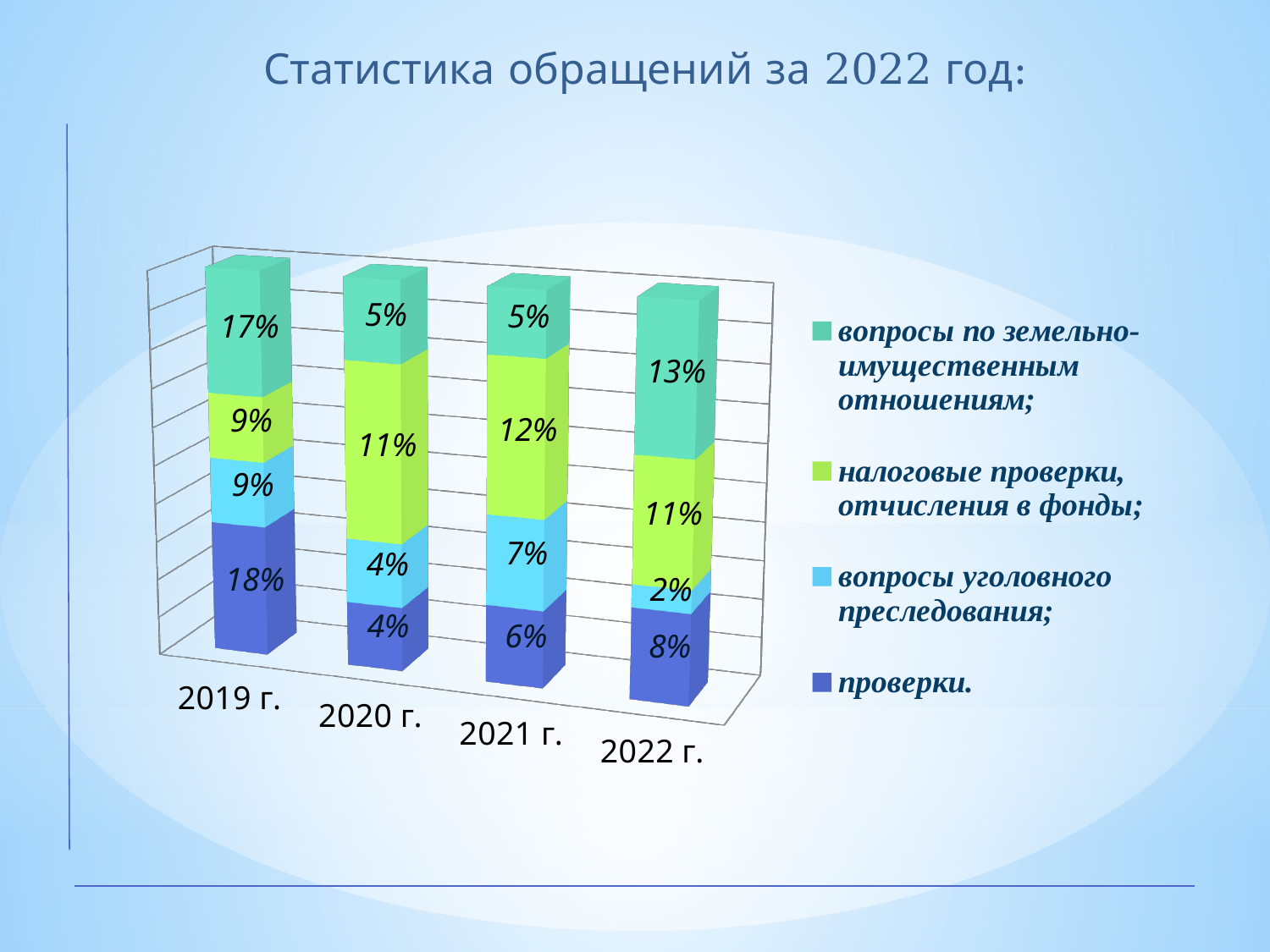
In which year is the value for «вопросы уголовного преследования» the lowest? 2022 г. In which year is the value for «проверки» the highest? 2019 г. What is the difference between the «вопросы по земельно-имущественным отношениям» values for 2019 г. and 2020 г.? 12% How many series does the legend list? 4 How many years (categories) are shown on the x axis? 4 What is the total of the stacked bar for 2022 г.? 34% Which is larger: «проверки» in 2021 г. or «проверки» in 2022 г.? 2022 г. What is the value for «вопросы уголовного преследования» in 2021 г.? 7% What is the value for «проверки» in 2019 г.? 18% What kind of chart is shown on the slide? Stacked bar chart What is the value for «налоговые проверки, отчисления в фонды» in 2020 г.? 11% What is the value for «вопросы по земельно-имущественным отношениям» in 2022 г.? 13%